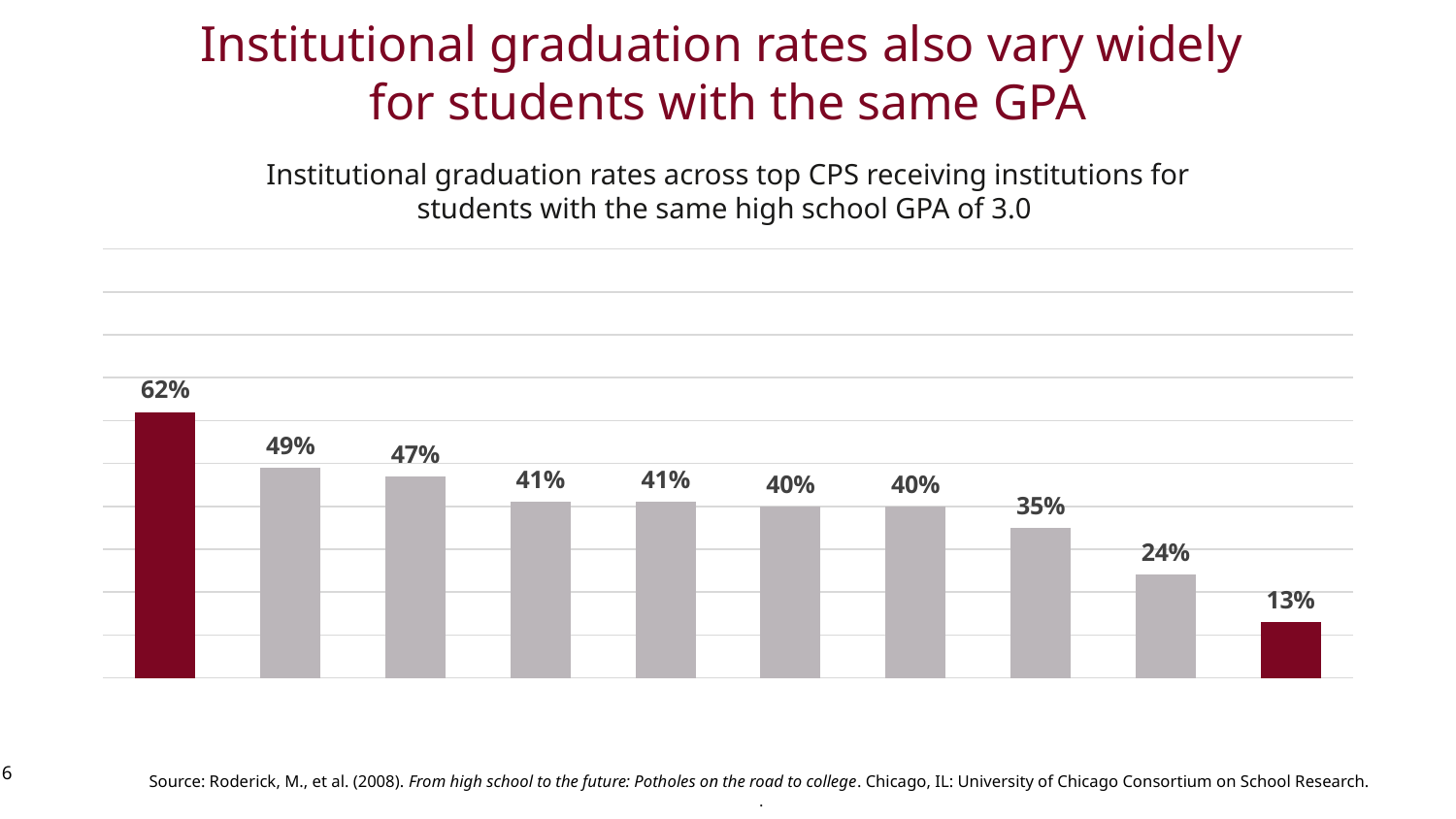
What kind of chart is shown on the slide? bar chart Do the bar values rise or fall from left to right across the chart? fall What is the value of the second bar from the right? 24% How many bars are plotted in the chart? 10 Which bars in the chart are coloured dark red rather than grey? the leftmost (62%) and rightmost (13%) bars What is the lowest value shown in the chart? 13% What is the highest value shown in the chart? 62% What is the value of the second bar from the left? 49% Which is larger, the value of the third bar from the left or the value of the eighth bar from the left? the third bar (47%) What is the value of the leftmost bar in the chart? 62% What is the difference between the highest and lowest values in the chart? 49 percentage points What is the value of the rightmost bar in the chart? 13%